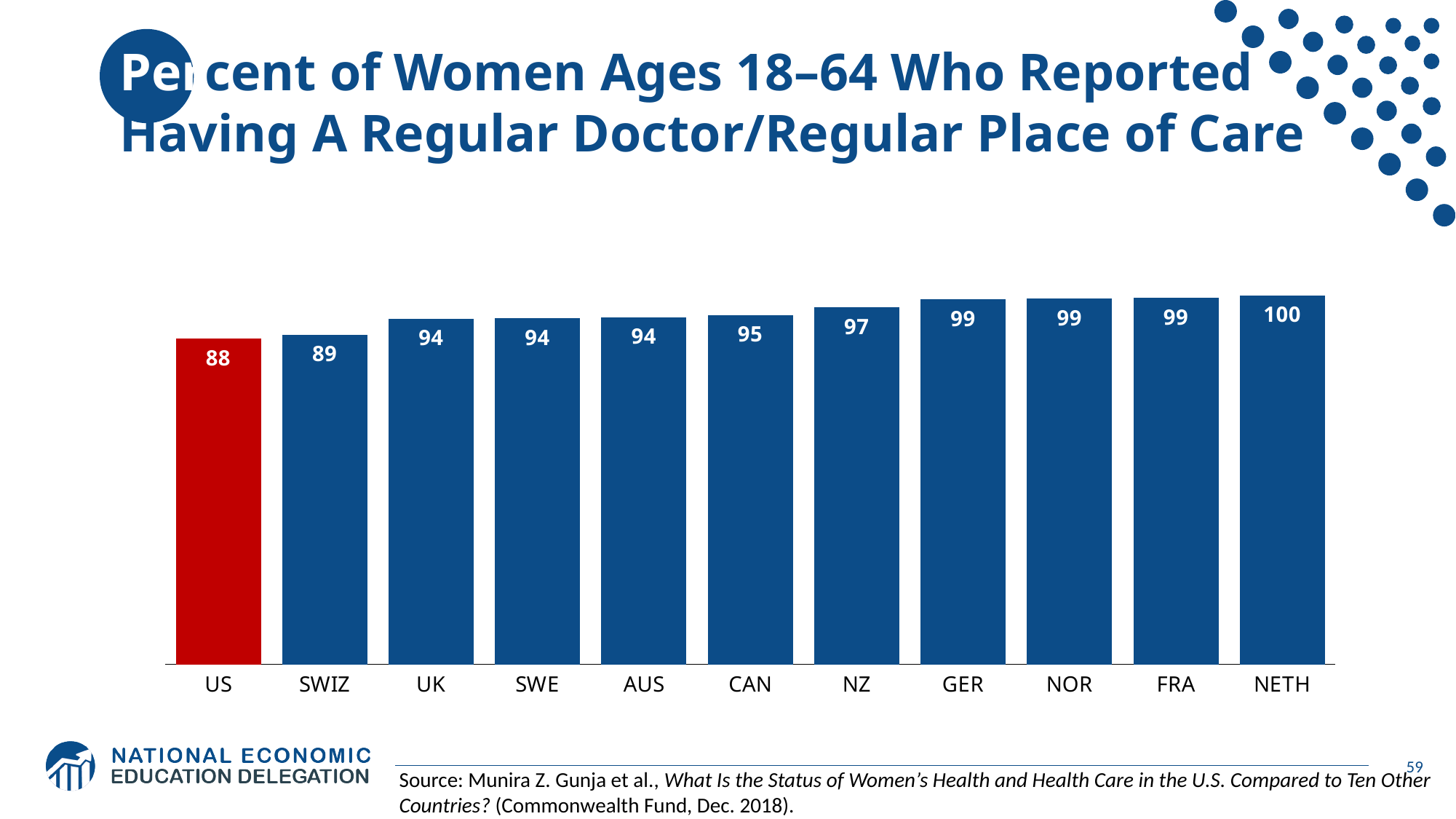
Which country has the highest value? NETH How many countries are shown on the chart? 11 Which country has the lowest value? US What is the value for the US? 88 What kind of chart is shown on the slide? bar chart What is the value for NZ? 97 Do the values rise or fall from left to right along the x axis? rise Which is larger, the value for UK or the value for NZ? NZ Which bar is coloured red rather than blue? US What is the difference between the values for NETH and the US? 12 What is the difference between the values for SWIZ and the US? 1 What is the value for CAN? 95